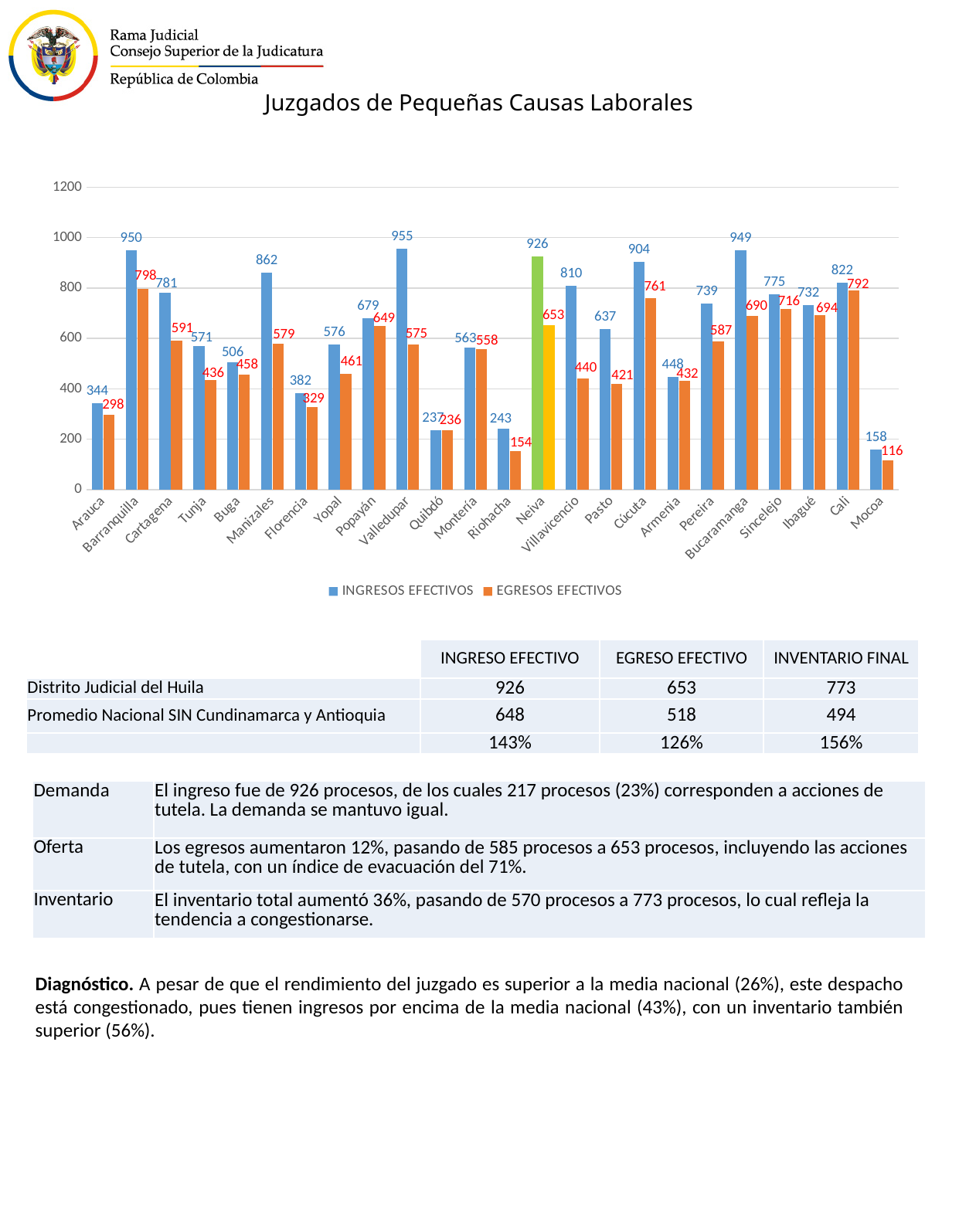
Which category has the highest INGRESOS EFECTIVOS value? Valledupar What is the EGRESOS EFECTIVOS value for Cúcuta? 761 How many categories (cities) are shown on the x axis of the chart? 24 Which is larger: the INGRESOS EFECTIVOS value for Cartagena or for Sincelejo? Cartagena Which category has the lowest EGRESOS EFECTIVOS value? Mocoa Which category's bars are highlighted in green and yellow instead of blue and orange? Neiva What is the INGRESOS EFECTIVOS value for Manizales? 862 What is the difference between INGRESOS EFECTIVOS and EGRESOS EFECTIVOS for Villavicencio? 370 How many series does the chart legend list? 2 What is the INGRESOS EFECTIVOS value for Neiva? 926 What kind of chart is shown on the slide? Bar chart Is the EGRESOS EFECTIVOS value for Pereira greater or less than 600? less